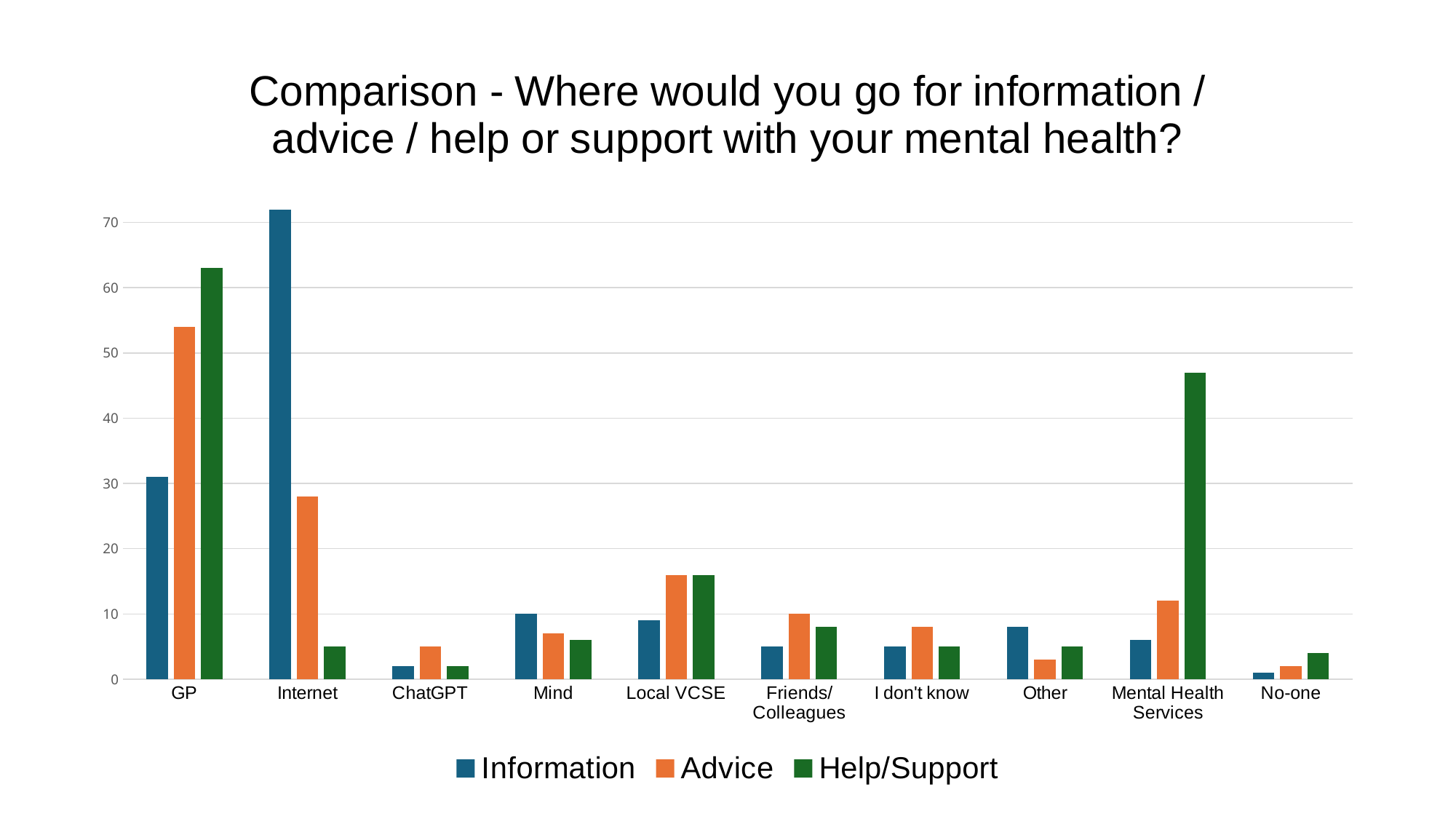
Which category has the highest value for the Help/Support series? GP How many categories are shown on the x axis? 10 How many series does the legend list? 3 For GP, which is larger: the Information value or the Advice value? Advice What kind of chart is shown on the slide? bar chart Is the Help/Support value for Mental Health Services greater or less than 50? less Is the Information value for Internet greater or less than 70? greater Which series is shown in green in the legend? Help/Support Is the Advice value for GP greater or less than 50? greater Which category has the highest value for the Advice series? GP Which category has the highest value for the Information series? Internet Which category has the lowest value for the Information series? No-one